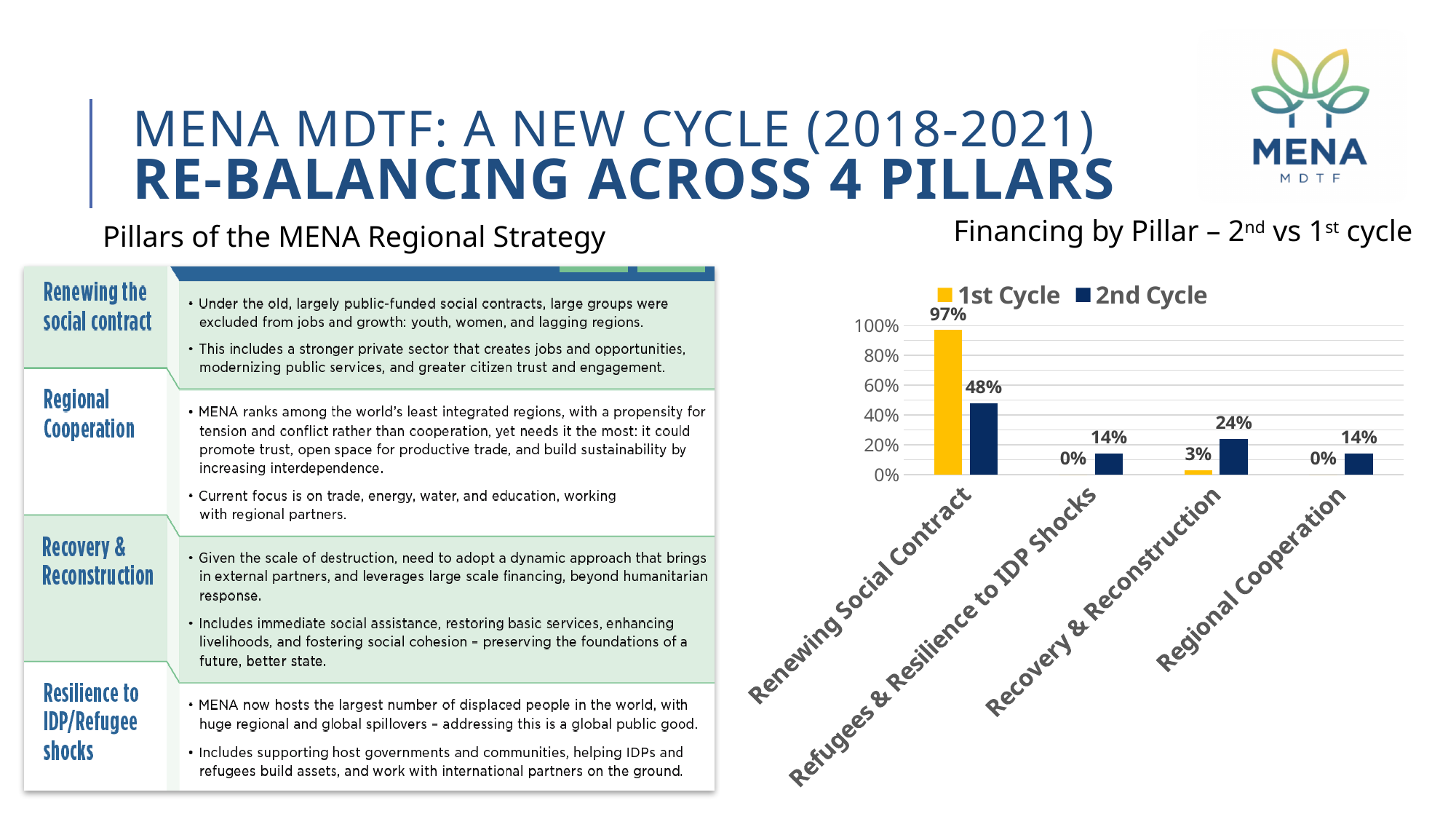
What is the 2nd Cycle value for Recovery & Reconstruction? 24% Which category has the highest 2nd Cycle value? Renewing Social Contract What is the 2nd Cycle value for Refugees & Resilience to IDP Shocks? 14% What is the 1st Cycle value for Regional Cooperation? 0% For Recovery & Reconstruction, which is larger: the 1st Cycle value or the 2nd Cycle value? 2nd Cycle What kind of chart is shown on the slide? Bar chart Which category has the lowest 2nd Cycle value? Refugees & Resilience to IDP Shocks and Regional Cooperation (both 14%) How many series does the chart legend list? 2 What is the difference between the 1st Cycle and 2nd Cycle values for Renewing Social Contract? 49 percentage points What is the 1st Cycle value for Renewing Social Contract? 97% Which colour represents the 1st Cycle series in the chart? Yellow How many categories are shown on the x axis of the chart? 4